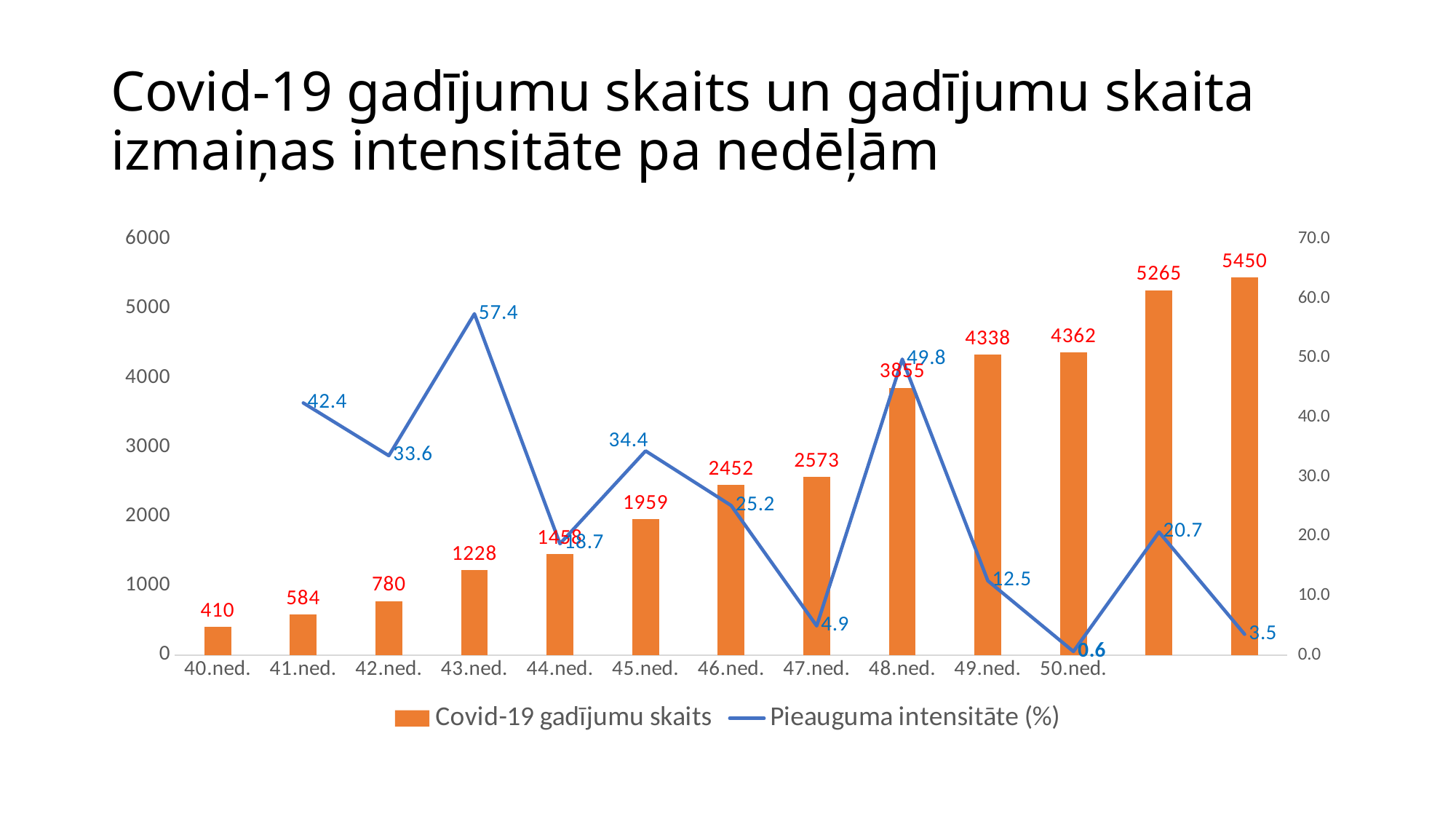
Which week has the lowest Covid-19 gadījumu skaits value? 40.ned. What is the difference in Covid-19 gadījumu skaits between 48.ned. and 47.ned.? 1282 Which week has the highest Pieauguma intensitāte (%) value? 43.ned. What kind of chart is shown on the slide? Combination bar and line chart How many bars are plotted in the chart? 13 What is the Pieauguma intensitāte (%) value for 43.ned.? 57.4 How many series does the legend list? 2 What is the Covid-19 gadījumu skaits value for 49.ned.? 4338 Which is larger, the Pieauguma intensitāte (%) for 41.ned. or for 42.ned.? 41.ned. What is the Covid-19 gadījumu skaits value for 45.ned.? 1959 Do the Covid-19 gadījumu skaits values rise or fall from 40.ned. to 50.ned.? Rise Which week has the lowest Pieauguma intensitāte (%) value? 50.ned.